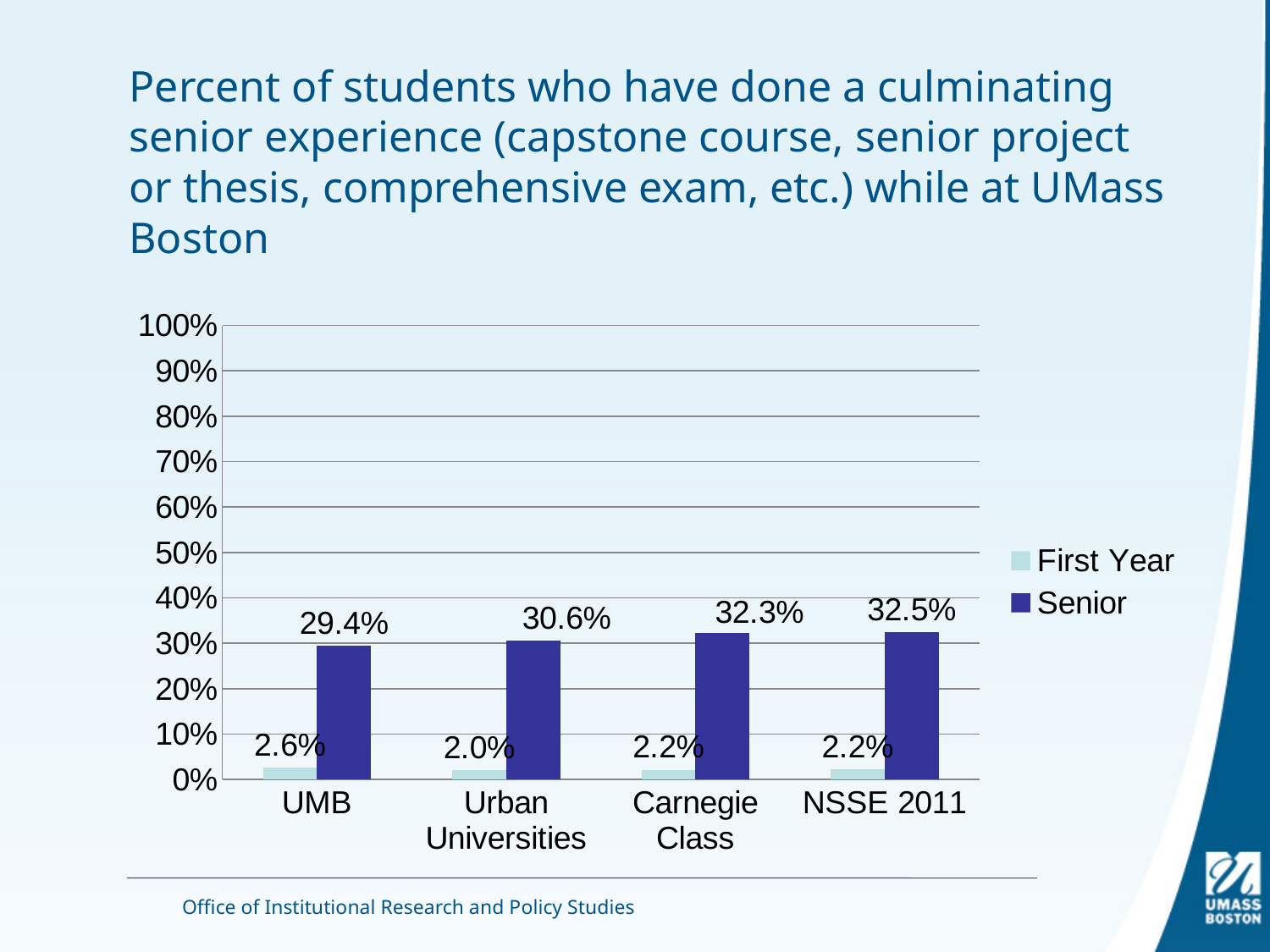
How many series does the legend list? 2 Which category has the lowest First Year value? Urban Universities What is the First Year value for Urban Universities? 2.0% Which is larger, the Senior value for Carnegie Class or the Senior value for Urban Universities? Carnegie Class What is the difference between the Senior values for NSSE 2011 and UMB? 3.1% What is the First Year value for UMB? 2.6% What is the Senior value for UMB? 29.4% Which category has the lowest Senior value? UMB What is the Senior value for NSSE 2011? 32.5% Which category has the highest Senior value? NSSE 2011 What kind of chart is shown on the slide? Bar chart How many categories are shown on the x axis? 4